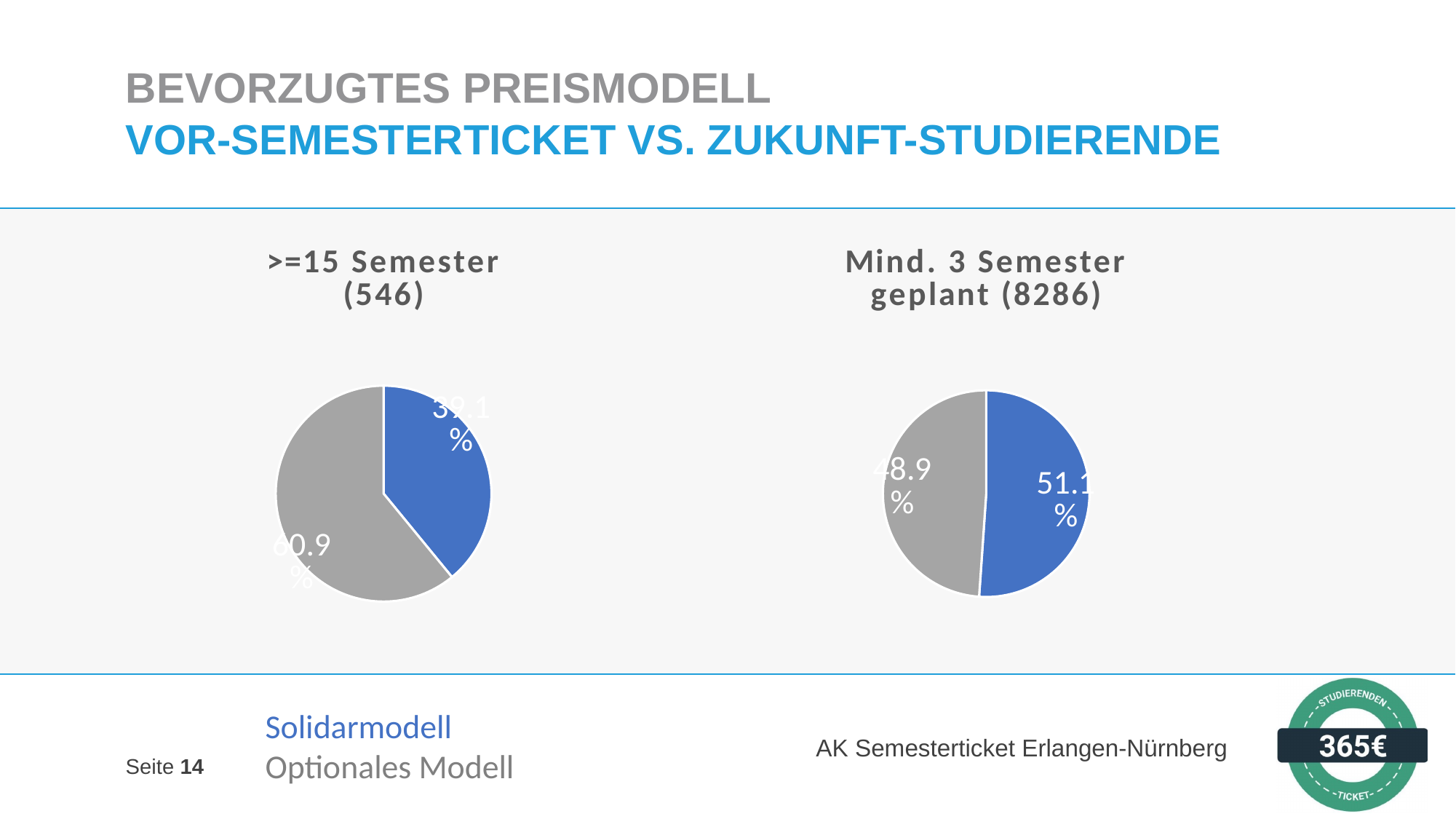
Is the Solidarmodell share larger in the '>=15 Semester (546)' chart or in the 'Mind. 3 Semester geplant (8286)' chart? Mind. 3 Semester geplant (8286) How many slices does the 'Mind. 3 Semester geplant (8286)' pie chart have? 2 In the '>=15 Semester (546)' chart, which model has the larger slice? Optionales Modell In the '>=15 Semester (546)' chart, what share does the Solidarmodell slice have? 39.1% In the 'Mind. 3 Semester geplant (8286)' chart, what share does the Optionales Modell slice have? 48.9% Which colour represents the Solidarmodell in the pie charts? blue How many entries does the legend below the charts list? 2 In the 'Mind. 3 Semester geplant (8286)' chart, what share does the Solidarmodell slice have? 51.1% What kind of chart is used for '>=15 Semester (546)'? pie chart In the '>=15 Semester (546)' chart, what is the difference between the Optionales Modell share and the Solidarmodell share? 21.8% In the 'Mind. 3 Semester geplant (8286)' chart, which model has the smaller slice? Optionales Modell